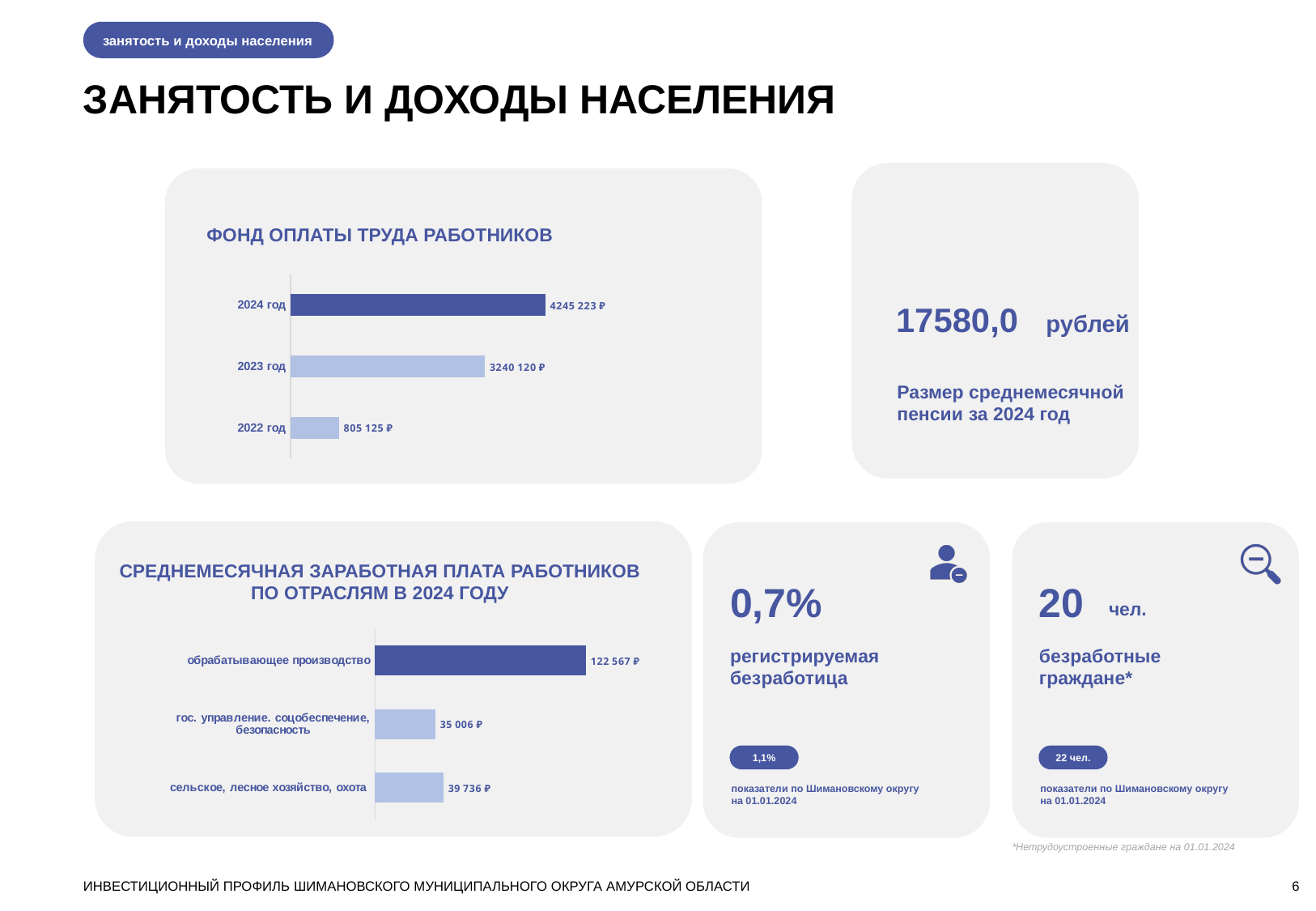
In the chart 'СРЕДНЕМЕСЯЧНАЯ ЗАРАБОТНАЯ ПЛАТА РАБОТНИКОВ ПО ОТРАСЛЯМ В 2024 ГОДУ', what is the difference between сельское, лесное хозяйство, охота and гос. управление, соцобеспечение, безопасность? 4 730 ₽ In the chart 'СРЕДНЕМЕСЯЧНАЯ ЗАРАБОТНАЯ ПЛАТА РАБОТНИКОВ ПО ОТРАСЛЯМ В 2024 ГОДУ', which is larger: гос. управление, соцобеспечение, безопасность or сельское, лесное хозяйство, охота? сельское, лесное хозяйство, охота In the chart 'ФОНД ОПЛАТЫ ТРУДА РАБОТНИКОВ', which year has the lowest value? 2022 год In the chart 'ФОНД ОПЛАТЫ ТРУДА РАБОТНИКОВ', what is the value for 2024 год? 4245 223 ₽ In the chart 'СРЕДНЕМЕСЯЧНАЯ ЗАРАБОТНАЯ ПЛАТА РАБОТНИКОВ ПО ОТРАСЛЯМ В 2024 ГОДУ', which industry has the highest value? обрабатывающее производство In the chart 'ФОНД ОПЛАТЫ ТРУДА РАБОТНИКОВ', what is the value for 2022 год? 805 125 ₽ How many years are shown in the chart 'ФОНД ОПЛАТЫ ТРУДА РАБОТНИКОВ'? 3 In the chart 'СРЕДНЕМЕСЯЧНАЯ ЗАРАБОТНАЯ ПЛАТА РАБОТНИКОВ ПО ОТРАСЛЯМ В 2024 ГОДУ', what is the value for обрабатывающее производство? 122 567 ₽ In the chart 'ФОНД ОПЛАТЫ ТРУДА РАБОТНИКОВ', what is the difference between the 2024 год and 2023 год values? 1005 103 ₽ In the chart 'СРЕДНЕМЕСЯЧНАЯ ЗАРАБОТНАЯ ПЛАТА РАБОТНИКОВ ПО ОТРАСЛЯМ В 2024 ГОДУ', what is the value for сельское, лесное хозяйство, охота? 39 736 ₽ In the chart 'ФОНД ОПЛАТЫ ТРУДА РАБОТНИКОВ', do the values rise or fall from 2022 to 2024? rise What kind of chart is 'СРЕДНЕМЕСЯЧНАЯ ЗАРАБОТНАЯ ПЛАТА РАБОТНИКОВ ПО ОТРАСЛЯМ В 2024 ГОДУ'? bar chart